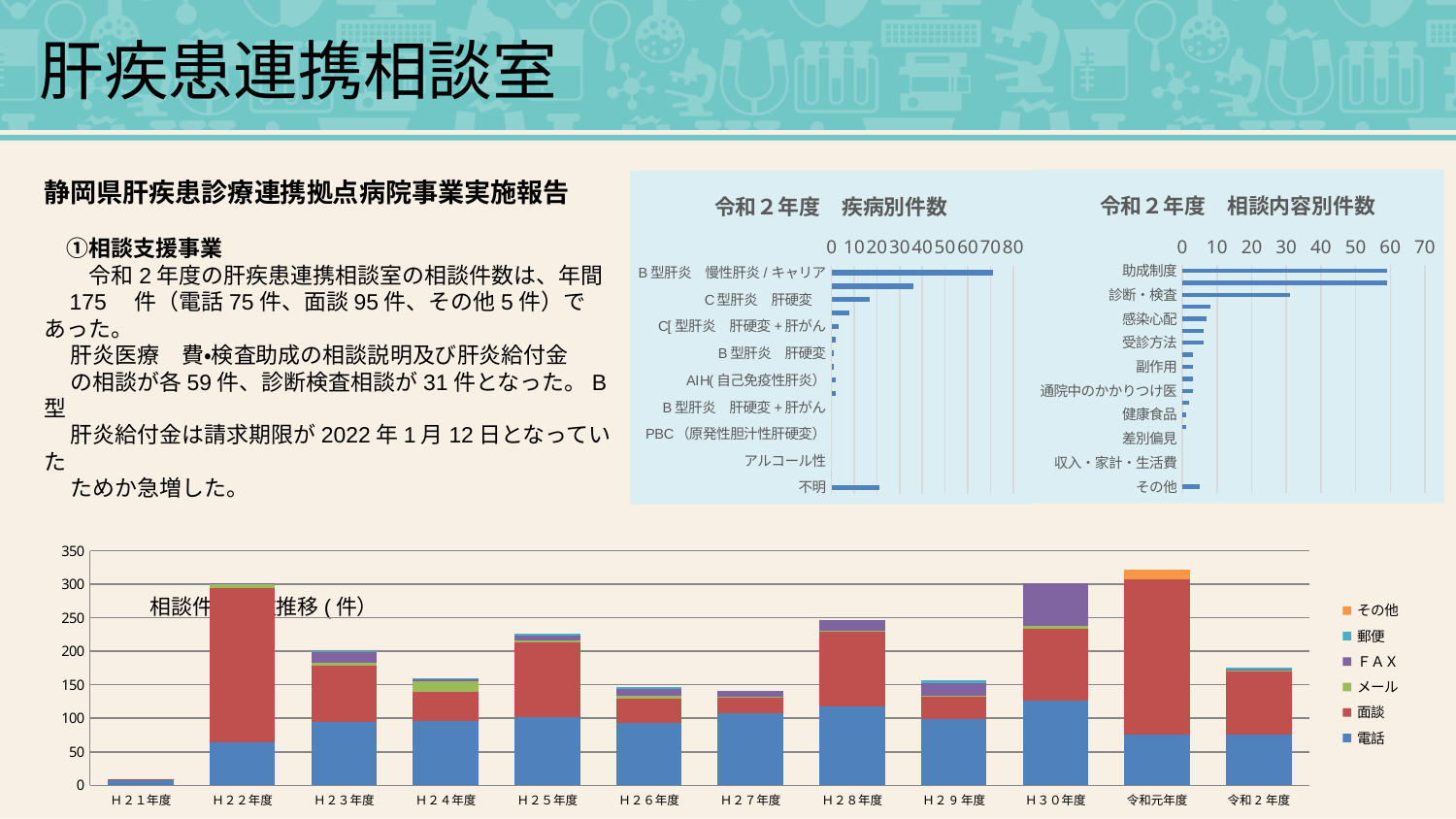
In the bottom chart, which fiscal year has the highest total? 令和元年度 In the bottom chart, which fiscal year has the lowest total? Ｈ２１年度 In the chart titled 令和２年度 相談内容別件数, how many categories are listed on the vertical axis? 10 In the bottom chart, which has the larger total, Ｈ２２年度 or Ｈ２３年度? Ｈ２２年度 In the bottom chart, how many fiscal-year categories are shown on the x axis? 12 In the chart titled 令和２年度 疾病別件数, which category has the highest value? Ｂ型肝炎 慢性肝炎/キャリア In the bottom chart, is the total for 令和２年度 greater or less than 150? greater In the bottom chart, is the total for Ｈ２１年度 greater or less than 50? less What kind of chart is the bottom chart on the slide? bar chart In the chart titled 令和２年度 相談内容別件数, is the value for 助成制度 greater or less than 50? greater In the bottom chart, how many series does the legend list? 6